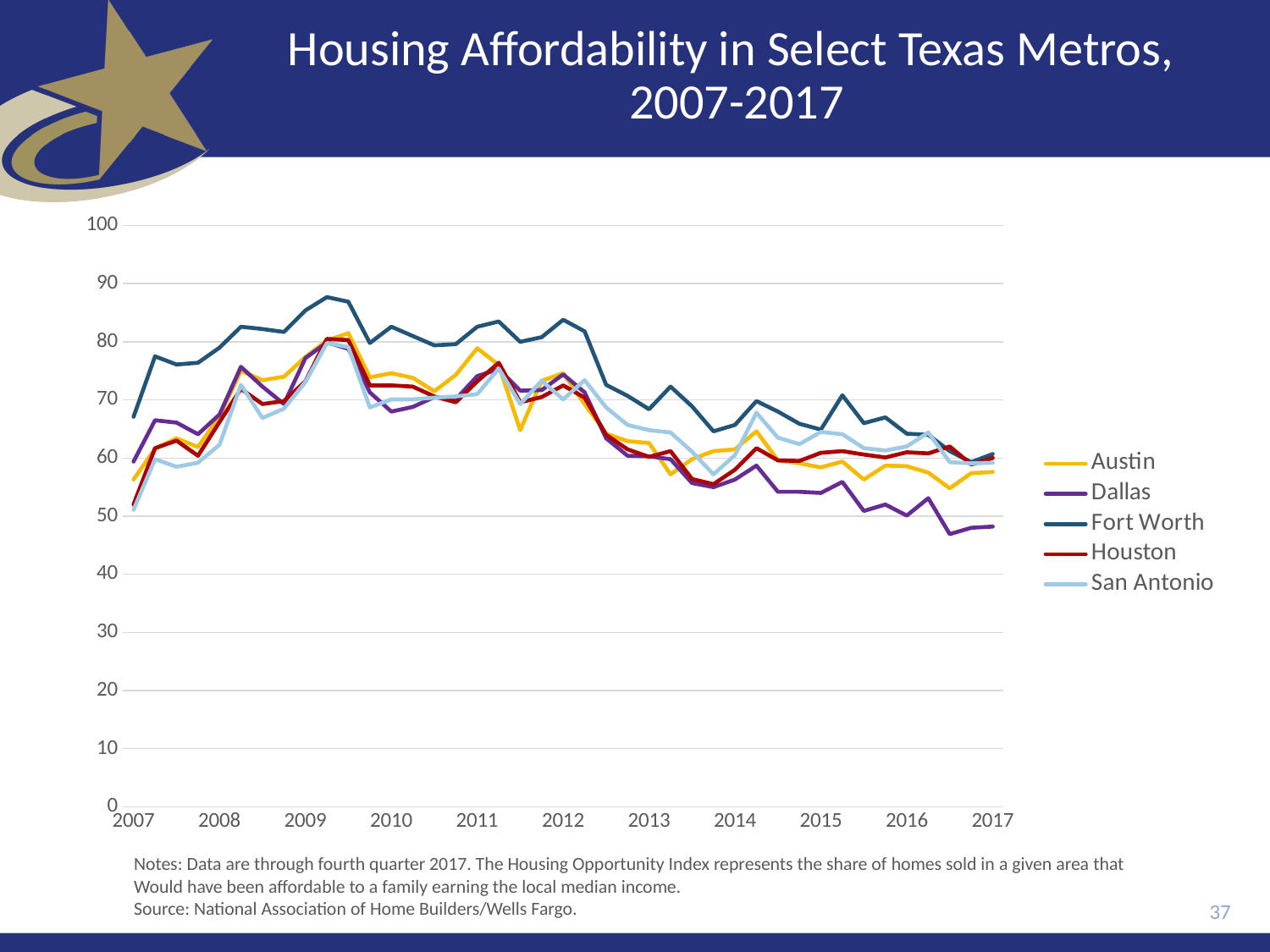
Is the value for Dallas at 2017 greater or less than 60? less At 2017, which is larger, the value for Fort Worth or the value for Dallas? Fort Worth Does the Fort Worth line rise or fall from 2009 to 2017? fall Is the value for Fort Worth at its 2009 peak greater or less than 80? greater Is the value for San Antonio at the start of 2007 greater or less than 60? less Which metro has the lowest value at 2017? Dallas What kind of chart is shown on the slide? line chart What is the title of the chart? Housing Affordability in Select Texas Metros, 2007-2017 Which metros are listed in the legend? Austin, Dallas, Fort Worth, Houston, San Antonio Which metro has the highest value around 2009? Fort Worth How many series does the legend list? 5 How many year labels are shown on the x axis? 11